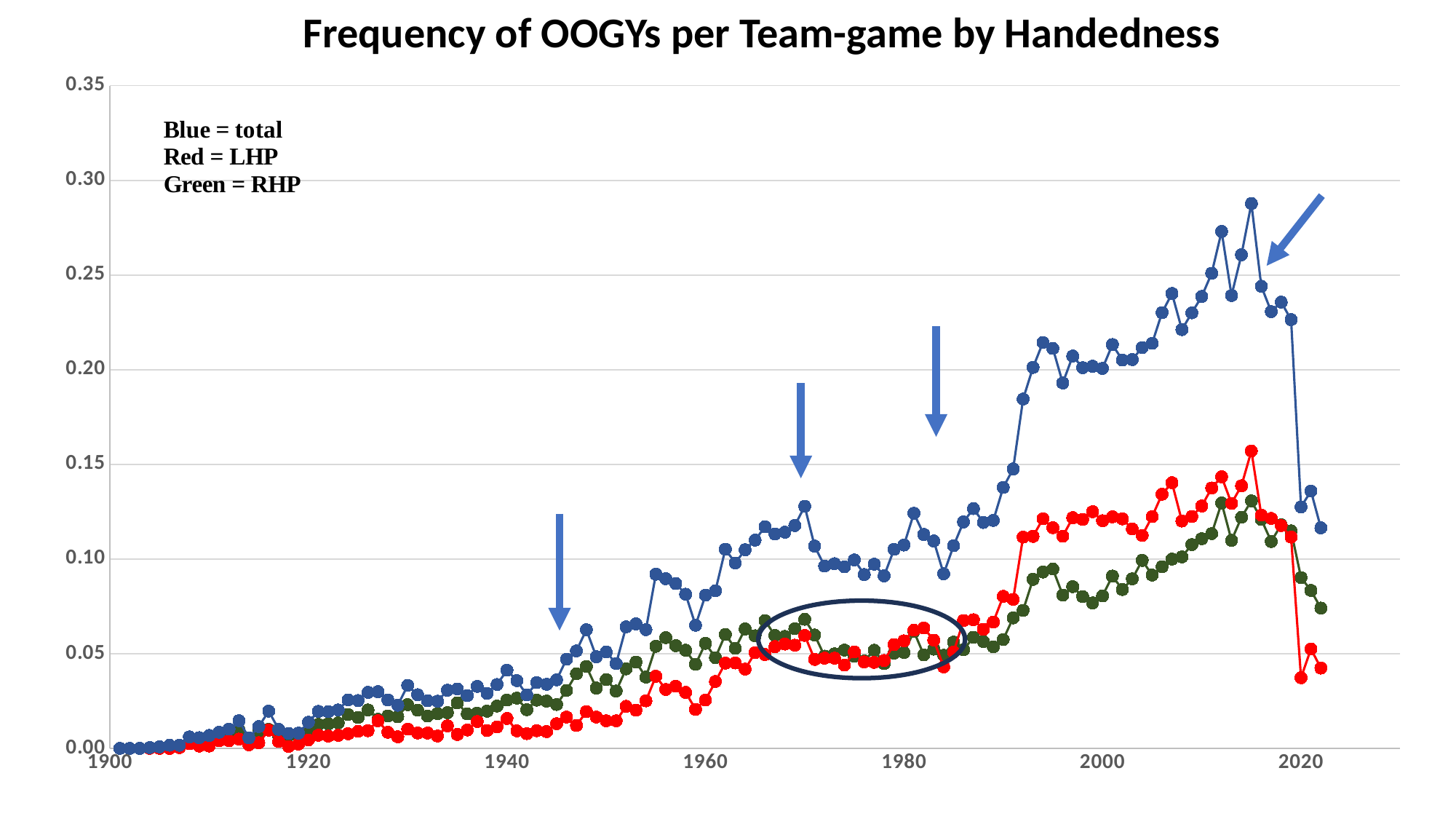
Is the value of the blue (total) series at 1940 greater or less than 0.05? less At 1950, which is higher: the red (LHP) series or the green (RHP) series? Green (RHP) Is the peak value of the blue (total) series around 2015 greater or less than 0.25? greater What is the title of the chart? Frequency of OOGYs per Team-game by Handedness Is the value of the green (RHP) series at the last plotted point (around 2022) greater or less than 0.10? less How many data series are plotted on the chart? 3 What kind of chart is shown on the slide? Line chart According to the legend text, which series does the red line represent? LHP Which series reaches the highest value on the chart? Blue (total) At 2000, which is higher: the red (LHP) series or the green (RHP) series? Red (LHP) Does the blue (total) series generally rise or fall from 1900 to around 2015? Rise